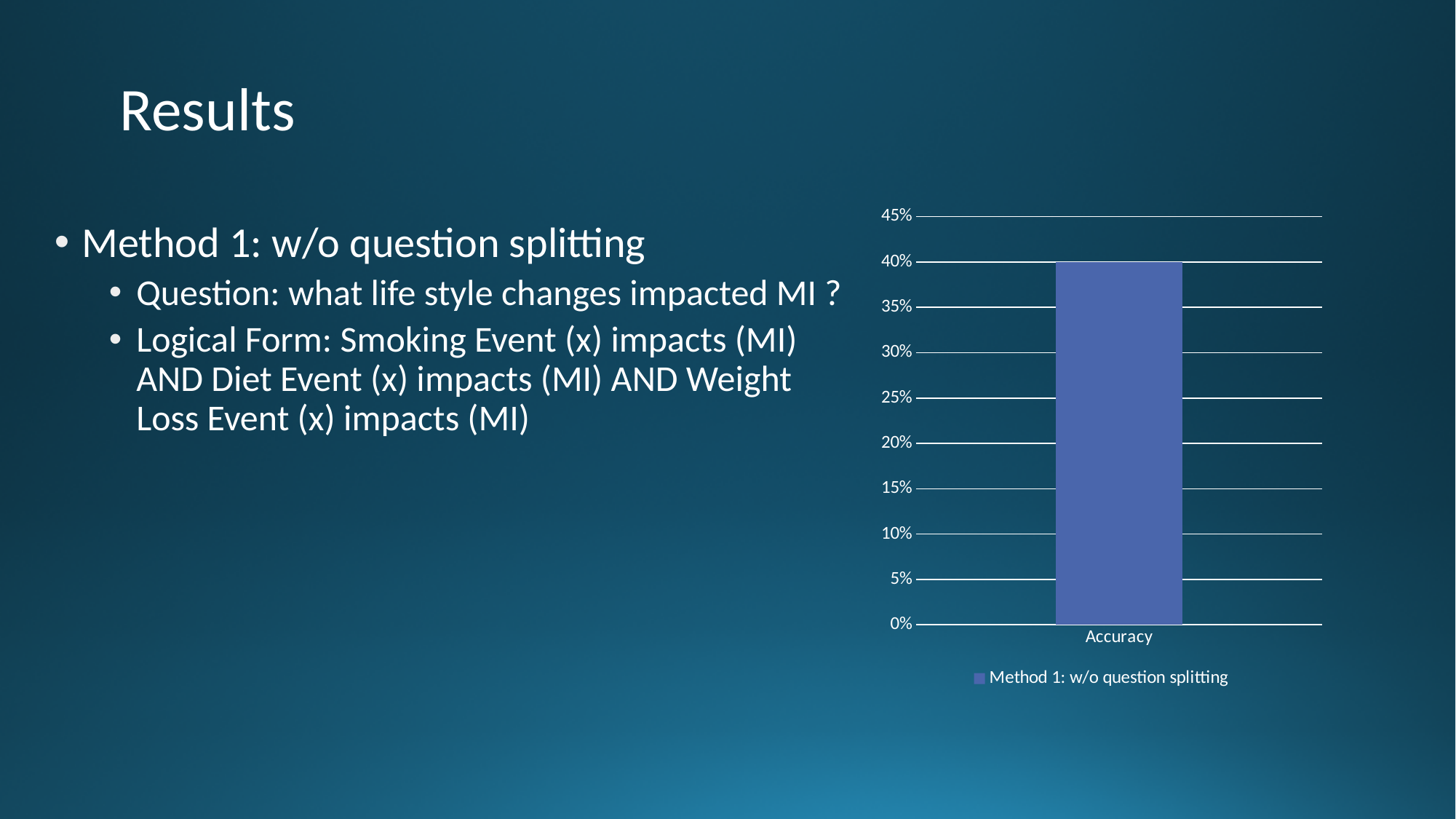
What kind of chart is shown on the slide? bar chart What is the label of the category on the x axis of the chart? Accuracy What is the value of the Accuracy bar? 40% What is the highest value shown on the chart's y axis? 45% Is the value for Accuracy greater or less than 35%? greater How many series does the chart's legend list? 1 What is the name of the series listed in the chart's legend? Method 1: w/o question splitting How many categories are shown on the x axis of the chart? 1 Is the value for Accuracy greater or less than 20%? greater Is the value for Accuracy greater or less than 45%? less